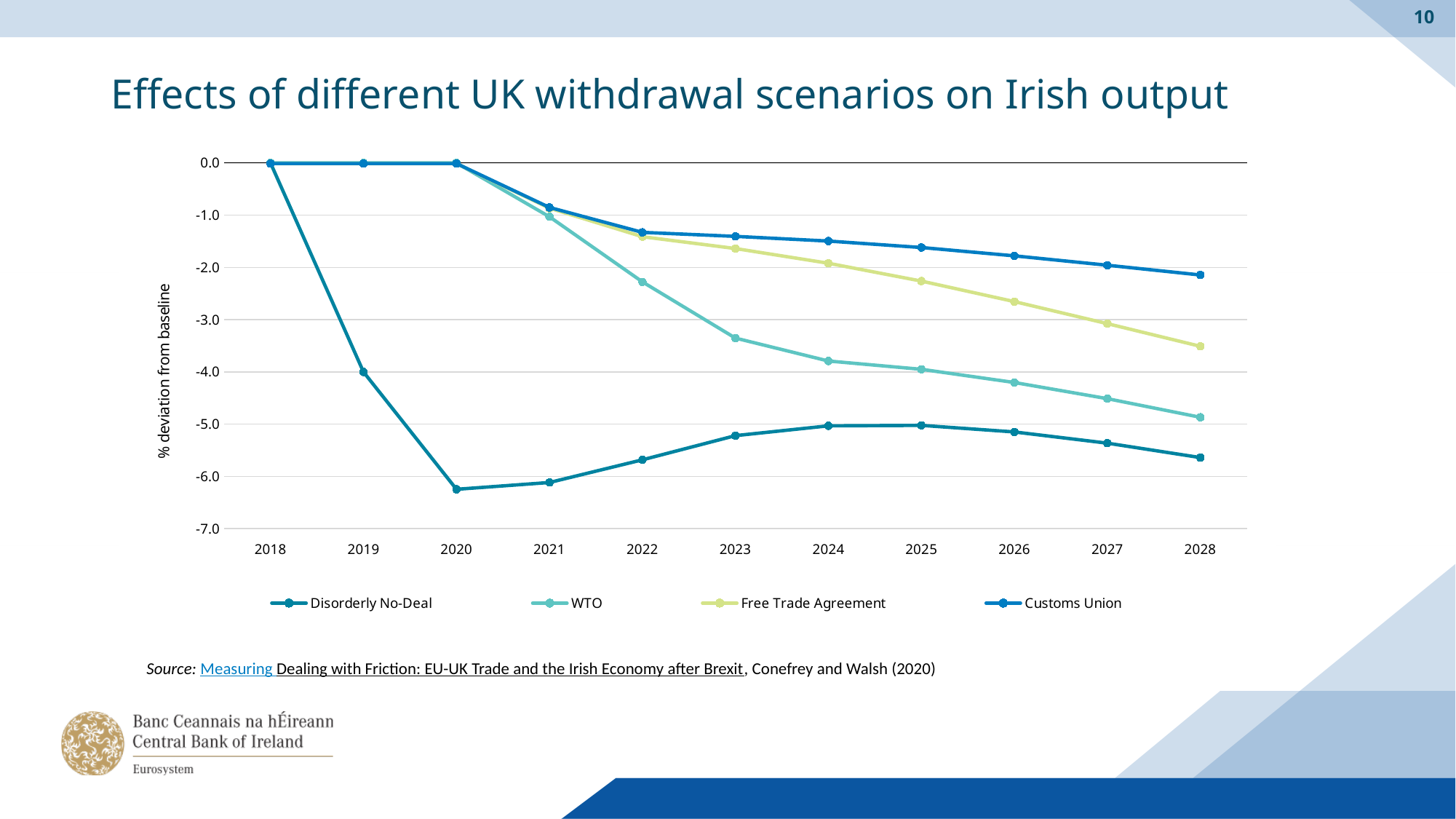
What is the value for WTO in 2020? 0.0 Does the Customs Union line rise or fall from 2021 to 2028? Fall What is the value for Disorderly No-Deal in 2019? -4.0 Is the value for Disorderly No-Deal in 2020 greater or less than -6.0? less What kind of chart is shown on the slide? Line chart Is the value for Free Trade Agreement in 2028 greater or less than -3.0? less Which scenario has the highest value in 2028? Customs Union How many series does the legend list? 4 Which scenario has the lowest value in 2028? Disorderly No-Deal What is the label on the y axis? % deviation from baseline Which is larger in 2025, the value for WTO or the value for Free Trade Agreement? Free Trade Agreement How many years are shown on the x axis? 11